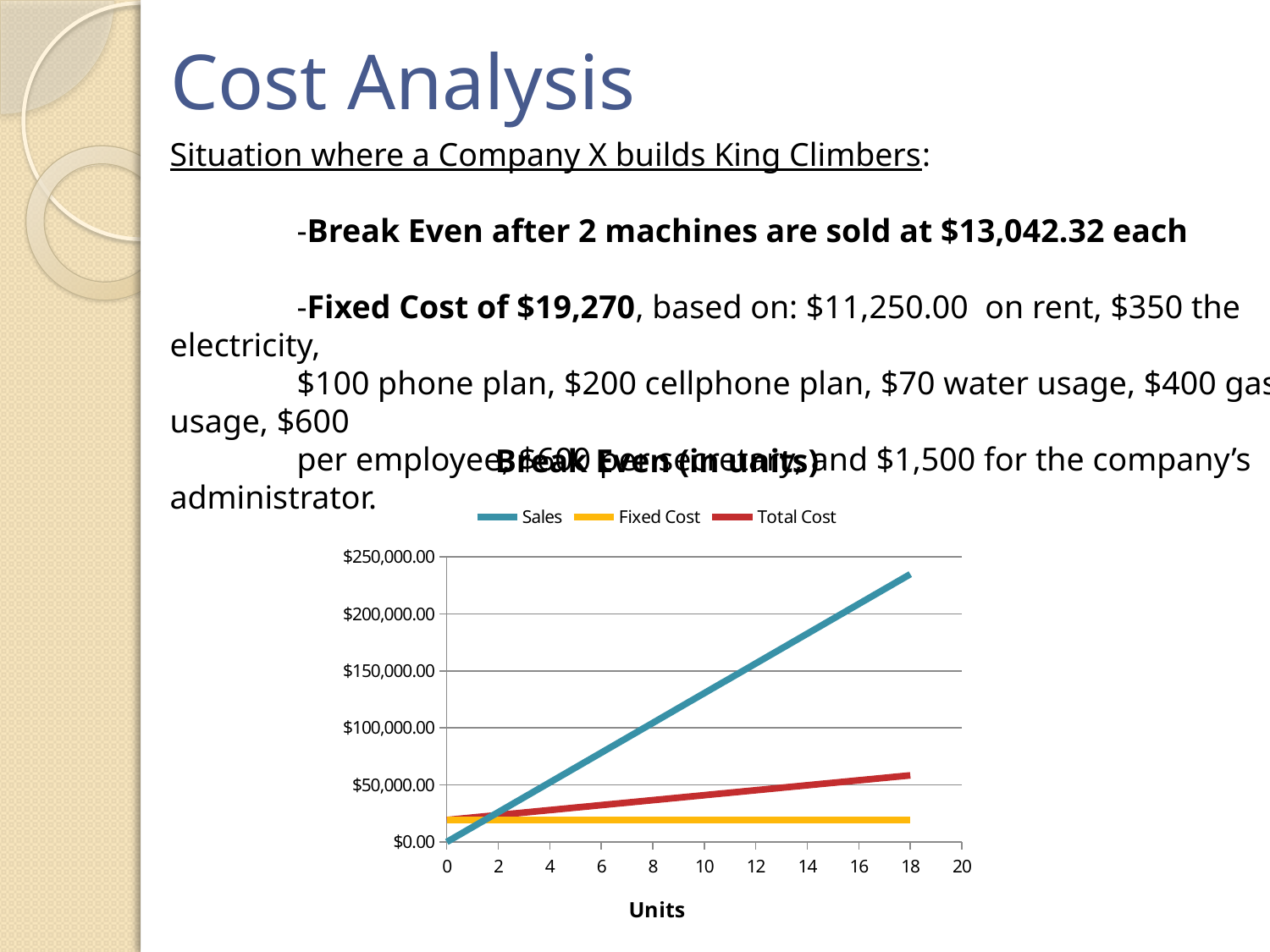
Which series has the lowest value at 18 units? Fixed Cost At 0 units, which is larger: Sales or Fixed Cost? Fixed Cost Does the Fixed Cost line rise, fall, or stay flat as units increase? stay flat Is the Fixed Cost value at 10 units greater or less than $50,000.00? less How many series does the chart's legend list? 3 What are the three series named in the chart's legend? Sales, Fixed Cost, Total Cost What kind of chart is shown on the slide? line chart Is the Sales value at 18 units greater or less than $200,000.00? greater Do the Sales values rise or fall as the number of units increases? rise What is the title of the chart's x axis? Units Is the Total Cost value at 18 units greater or less than $50,000.00? greater At 18 units, which is larger: Sales or Total Cost? Sales